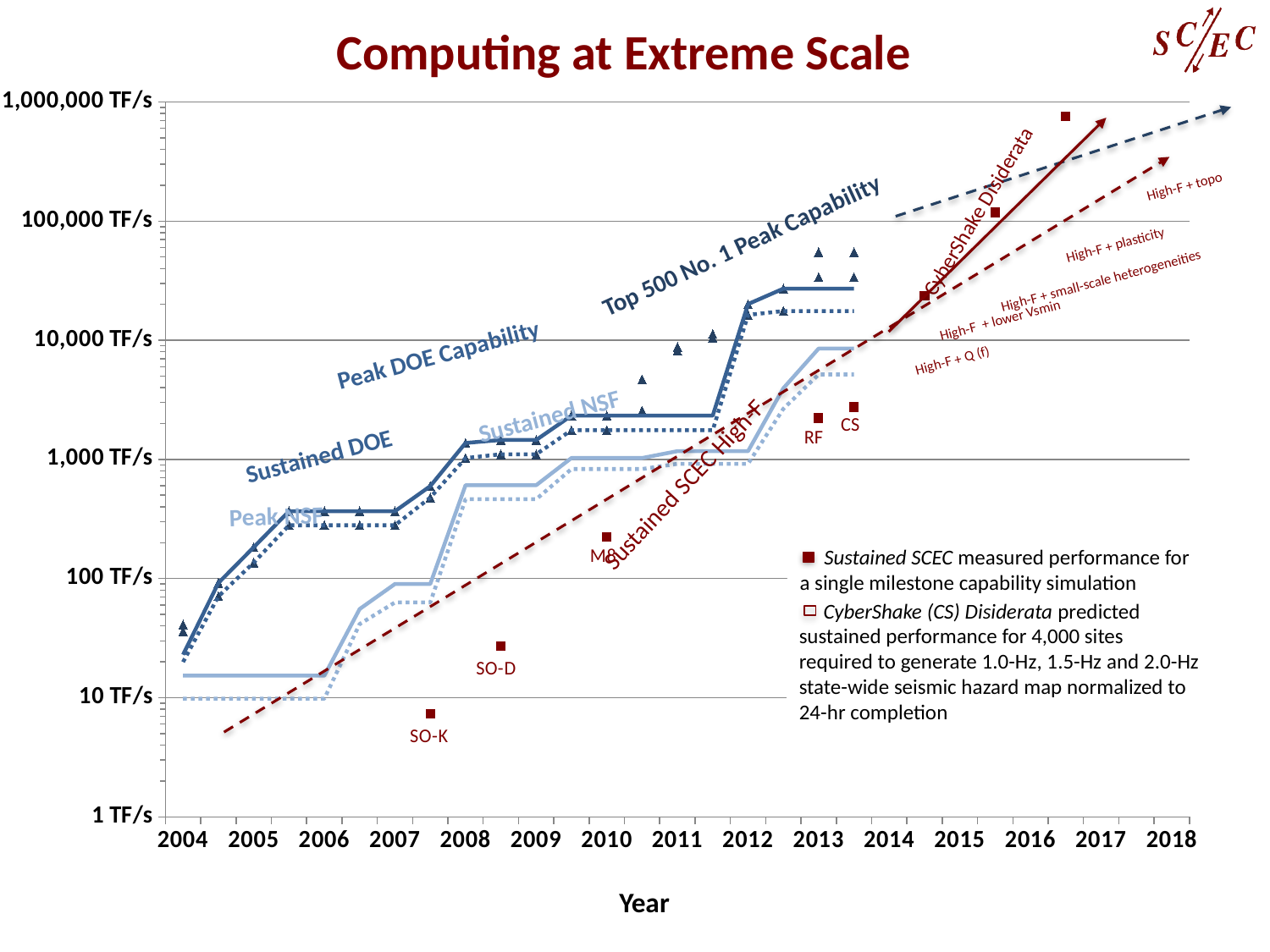
Is the value for the M8 milestone greater or less than 100 TF/s? greater Which of the labeled SCEC milestones, SO-K or SO-D, has the higher measured performance? SO-D Which labeled SCEC milestone has the lowest measured performance? SO-K What kind of chart is shown on the slide? line chart Does the Sustained DOE line rise or fall from 2004 to 2013? rise What is the title of the chart? Computing at Extreme Scale How many year ticks are shown on the x axis? 15 Is the value for the SO-D milestone greater or less than 10 TF/s? greater Is the value for the RF milestone greater or less than 1,000 TF/s? greater What is the label on the x axis of the chart? Year